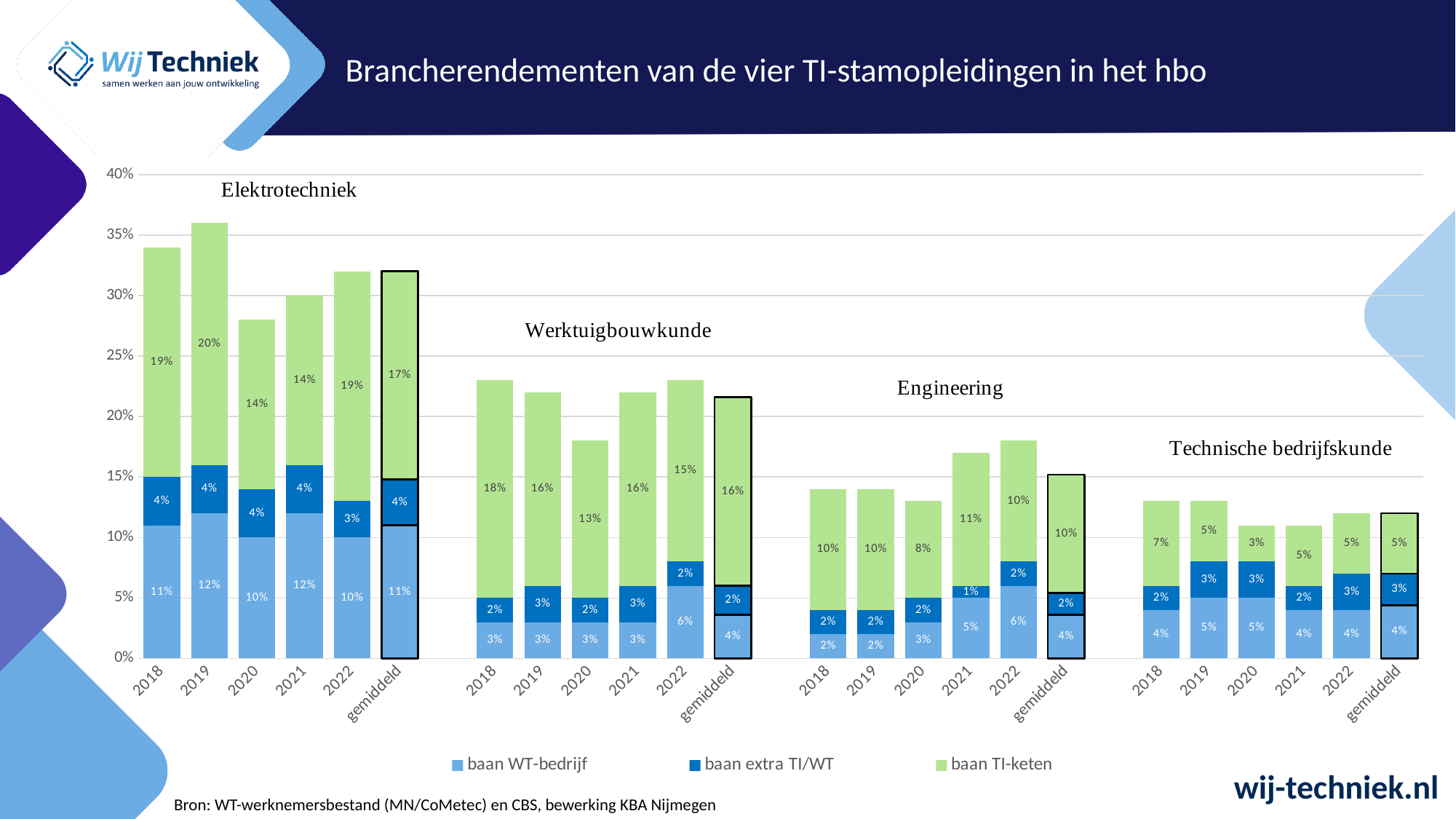
How many series does the legend list? 3 What is the total of the stacked bar for Engineering in 2022? 18% How many bars are shown in each opleiding group? 6 Which has the larger baan WT-bedrijf value in 2021: Engineering or Werktuigbouwkunde? Engineering Within the Elektrotechniek group, which year has the highest value for baan TI-keten? 2019 Within the Technische bedrijfskunde group, which year has the lowest value for baan TI-keten? 2020 What is the value of baan TI-keten for Elektrotechniek in 2019? 20% What is the total of the stacked bar for Elektrotechniek in 2019? 36% What is the value of baan extra TI/WT for the Engineering 'gemiddeld' bar? 2% What is the value of baan WT-bedrijf for Werktuigbouwkunde in 2022? 6% What kind of chart is shown on the slide? Stacked bar chart What is the difference between the baan TI-keten values for Werktuigbouwkunde in 2018 and 2020? 5 percentage points